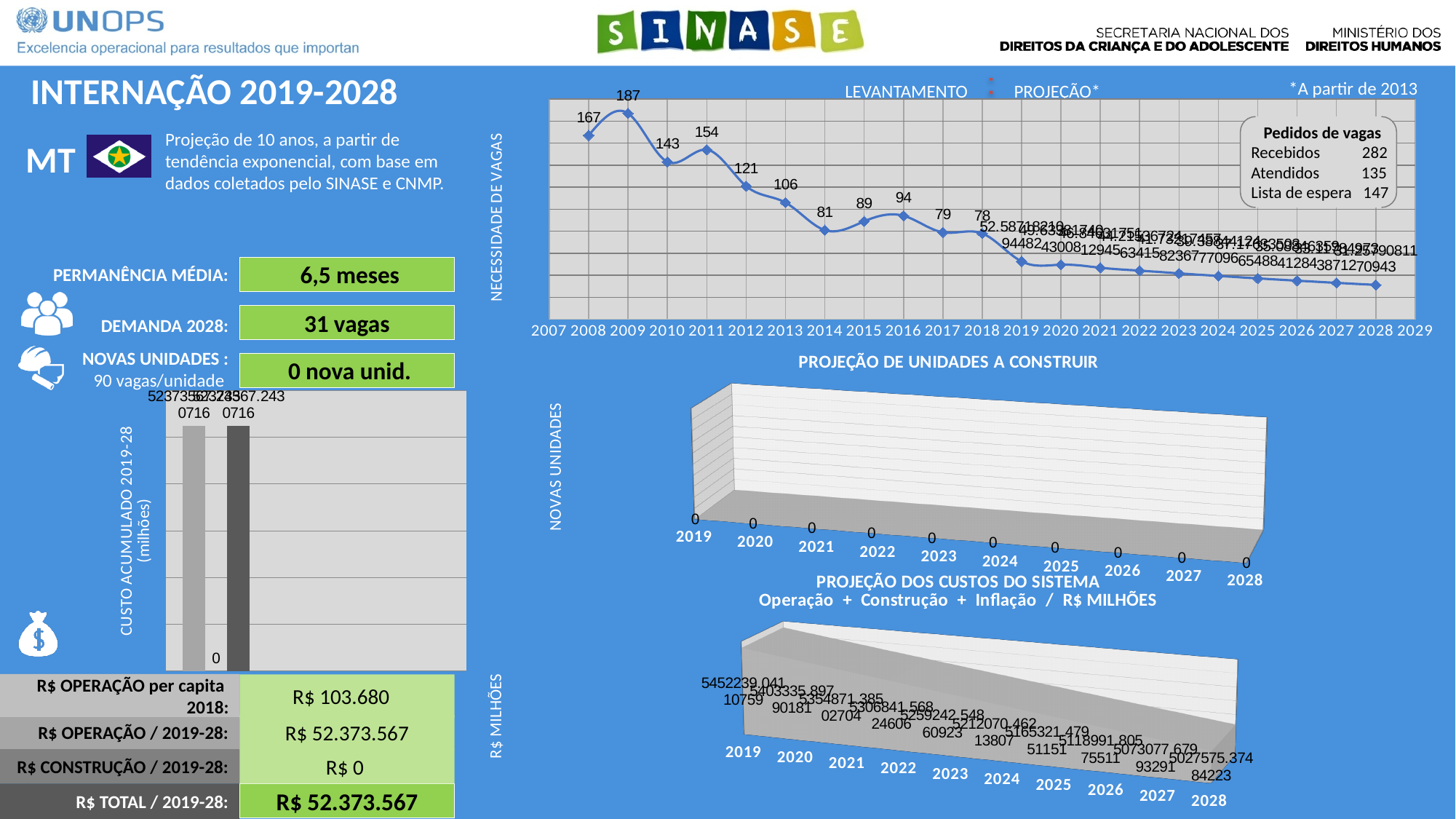
How many years are shown on the x axis of the PROJEÇÃO DE UNIDADES A CONSTRUIR chart? 10 In the PROJEÇÃO DE UNIDADES A CONSTRUIR chart, what is the value for 2019? 0 In the NECESSIDADE DE VAGAS line chart, what is the value for 2014? 81 In the NECESSIDADE DE VAGAS line chart, what is the value for 2009? 187 What kind of chart is the NECESSIDADE DE VAGAS chart at the top right? Line chart In the NECESSIDADE DE VAGAS line chart, do the values rise or fall from 2012 to 2014? Fall In the NECESSIDADE DE VAGAS line chart, what is the value for 2008? 167 In the NECESSIDADE DE VAGAS line chart, what is the difference between the values for 2009 and 2010? 44 In the NECESSIDADE DE VAGAS line chart, which year has the highest value? 2009 In the NECESSIDADE DE VAGAS line chart, which year has the larger value, 2010 or 2011? 2011 In the NECESSIDADE DE VAGAS line chart, what is the difference between the values for 2016 and 2017? 15